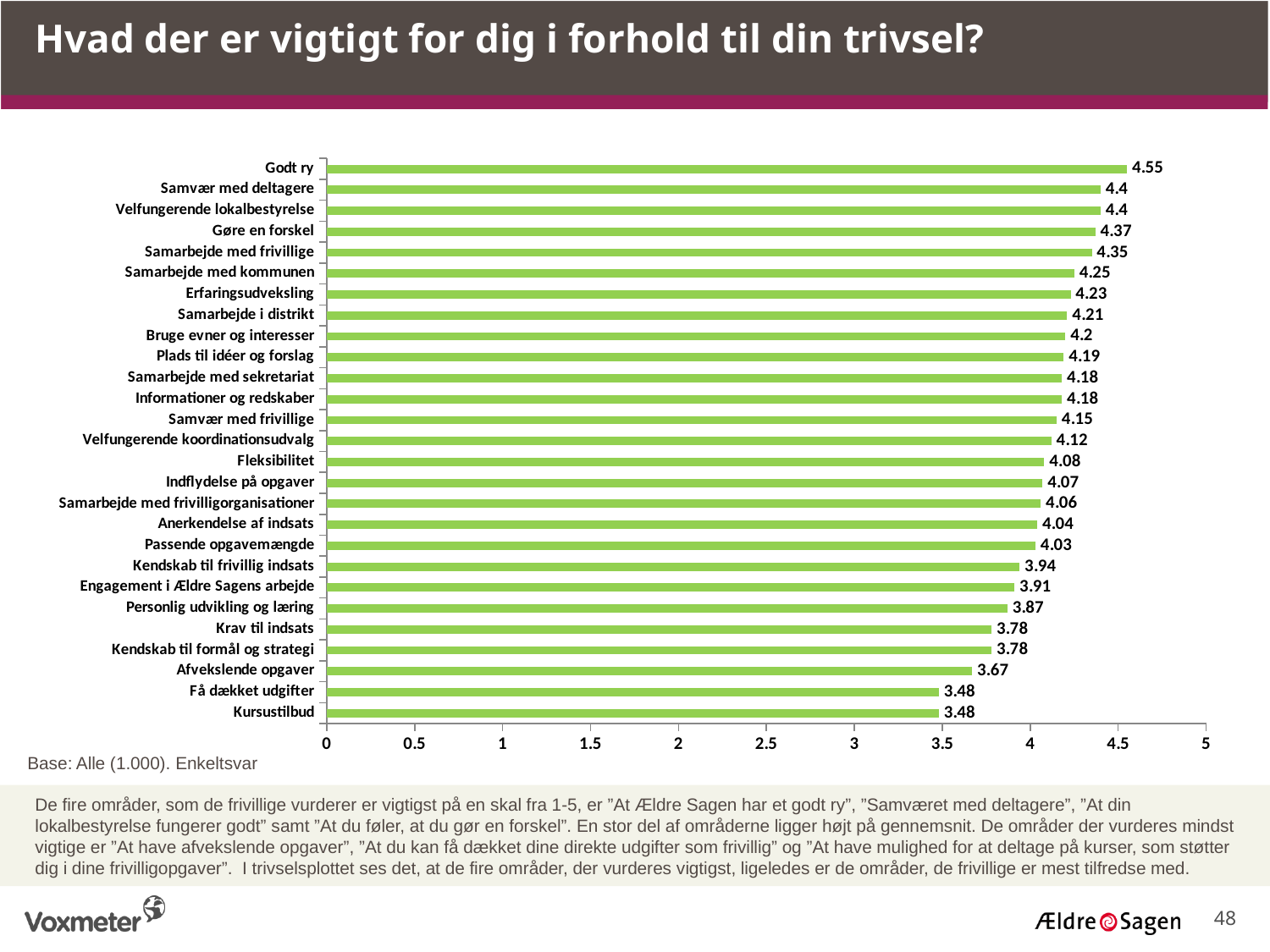
What is the value for Samarbejde med kommunen? 4.25 What is the difference between the values for Godt ry and Kursustilbud? 1.07 Which two categories share the lowest value? Få dækket udgifter and Kursustilbud Which is larger, the value for Erfaringsudveksling or the value for Passende opgavemængde? Erfaringsudveksling What is the value for Afvekslende opgaver? 3.67 Which category has the highest value? Godt ry What is the value for Fleksibilitet? 4.08 What is the value for Godt ry? 4.55 How many categories are shown in the chart? 27 What kind of chart is shown on the slide? bar chart What is the difference between the values for Gøre en forskel and Personlig udvikling og læring? 0.5 Is the value for Krav til indsats greater or less than 4? less